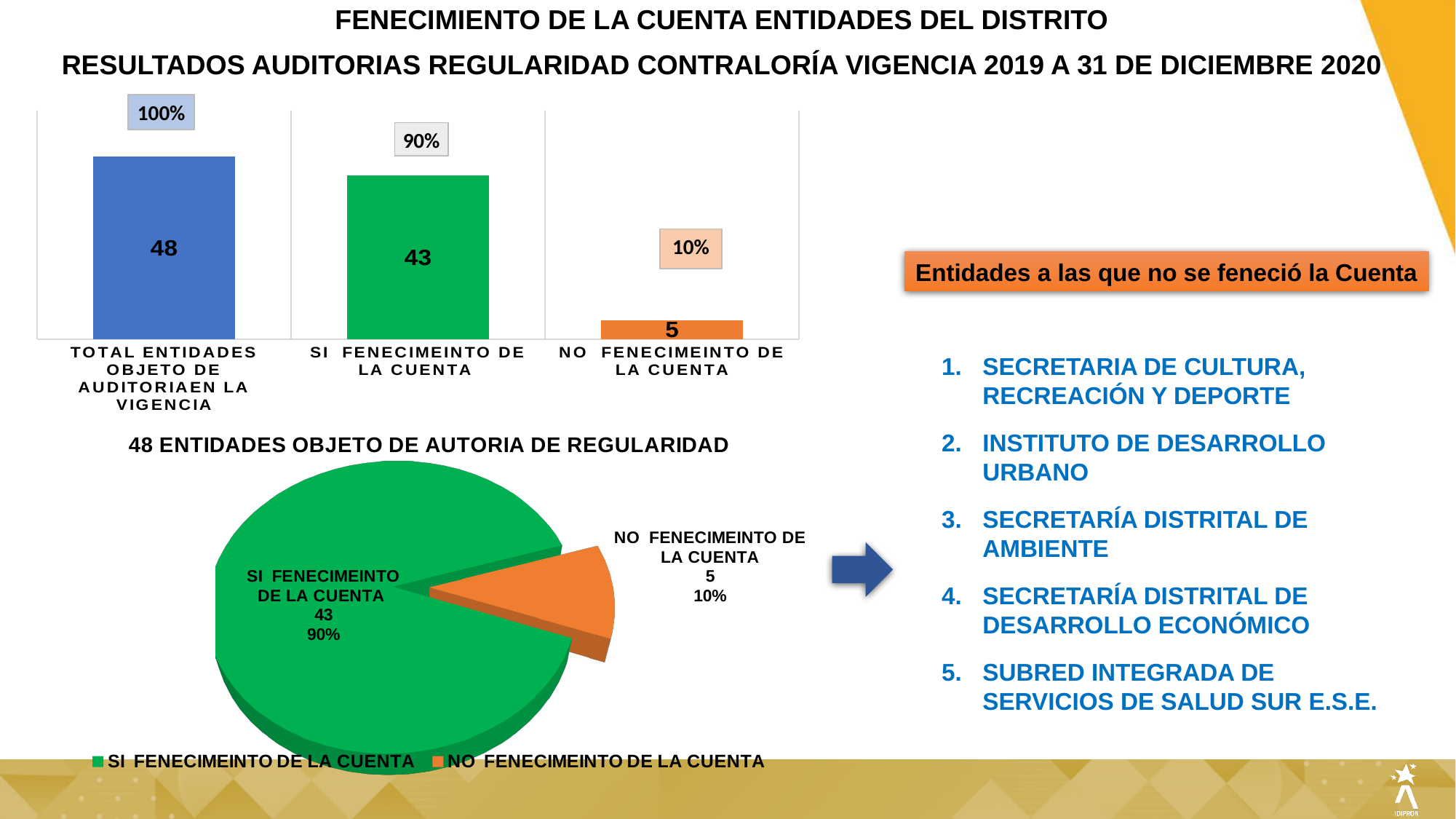
What kind of chart is the chart at the top of the slide? bar chart In the pie chart titled '48 ENTIDADES OBJETO DE AUTORIA DE REGULARIDAD', what share does SI FENECIMEINTO DE LA CUENTA have? 90% In the bar chart at the top of the slide, what is the difference between the SI FENECIMEINTO DE LA CUENTA value and the NO FENECIMEINTO DE LA CUENTA value? 38 In the bar chart at the top of the slide, what is the value for TOTAL ENTIDADES OBJETO DE AUDITORIA EN LA VIGENCIA? 48 In the pie chart titled '48 ENTIDADES OBJETO DE AUTORIA DE REGULARIDAD', what is the value for NO FENECIMEINTO DE LA CUENTA? 5 In the pie chart titled '48 ENTIDADES OBJETO DE AUTORIA DE REGULARIDAD', what colour is the SI FENECIMEINTO DE LA CUENTA slice? green In the bar chart at the top of the slide, which category has the lowest value? NO FENECIMEINTO DE LA CUENTA In the bar chart at the top of the slide, what is the value for SI FENECIMEINTO DE LA CUENTA? 43 In the bar chart at the top of the slide, which category has the highest value? TOTAL ENTIDADES OBJETO DE AUDITORIA EN LA VIGENCIA In the bar chart at the top of the slide, what percentage is shown above the NO FENECIMEINTO DE LA CUENTA bar? 10% In the bar chart at the top of the slide, how many categories are shown? 3 In the pie chart titled '48 ENTIDADES OBJETO DE AUTORIA DE REGULARIDAD', how many entries does the legend list? 2